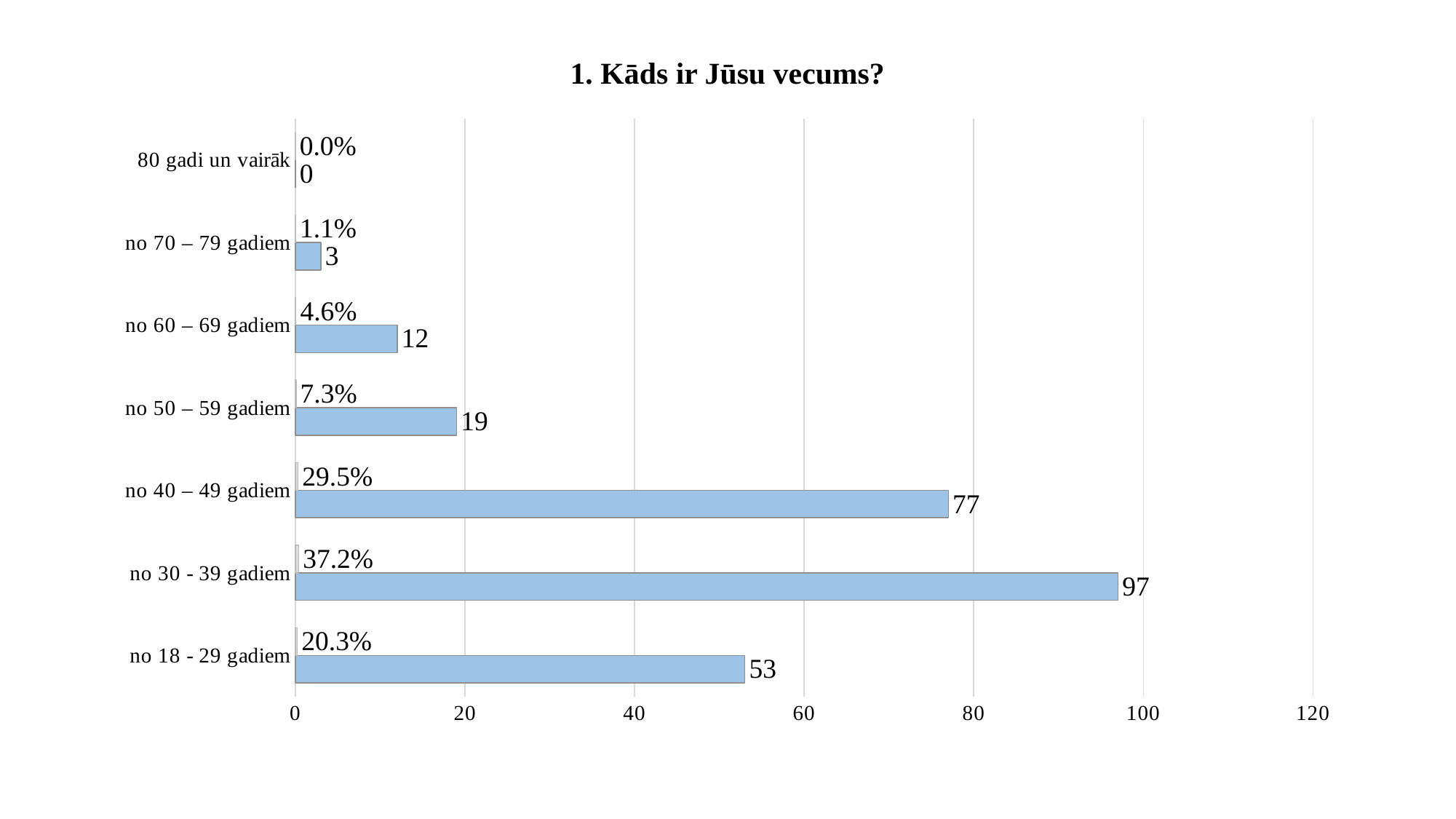
What percentage is shown for the category 'no 60 – 69 gadiem'? 4.6% Which has a larger count, 'no 50 – 59 gadiem' or 'no 60 – 69 gadiem'? no 50 – 59 gadiem Which age category has the highest count? no 30 - 39 gadiem Is the value for 'no 18 - 29 gadiem' greater or less than 40? greater Which age category has the lowest count? 80 gadi un vairāk What is the count for the category 'no 18 - 29 gadiem'? 53 What is the title of the chart? 1. Kāds ir Jūsu vecums? What percentage is shown for the category 'no 40 – 49 gadiem'? 29.5% What is the count for the category 'no 30 - 39 gadiem'? 97 What kind of chart is shown on the slide? bar chart How many age categories are shown on the chart? 7 What is the difference between the counts for 'no 30 - 39 gadiem' and 'no 40 – 49 gadiem'? 20